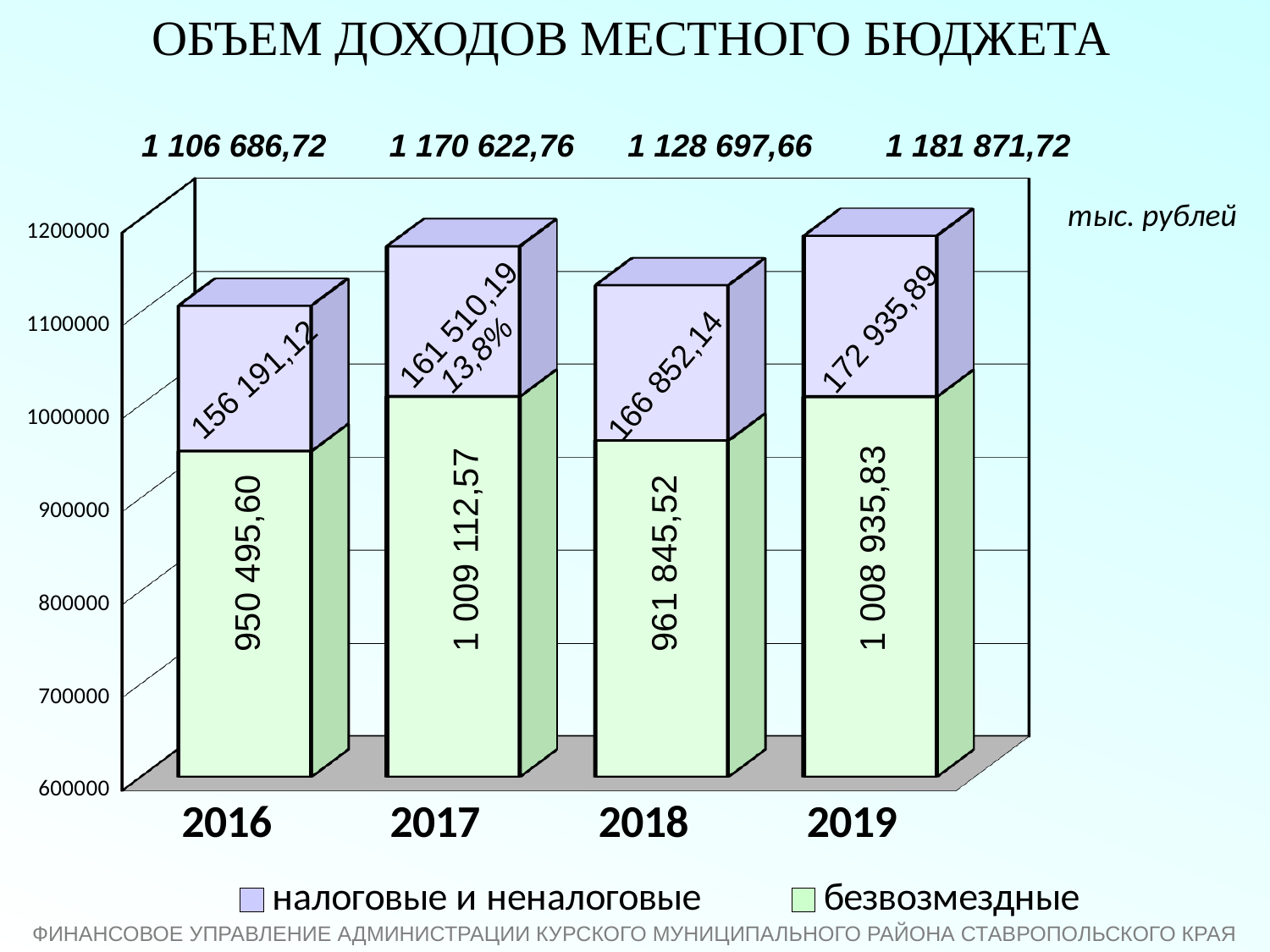
What is the total shown above the bar for 2019? 1 181 871,72 What is the value of налоговые и неналоговые for 2017? 161 510,19 How many series does the legend list? 2 What is the value of безвозмездные for 2018? 961 845,52 Which year has the lowest total income? 2016 What is the total shown above the bar for 2016? 1 106 686,72 How many years are shown on the x axis? 4 What is the value of безвозмездные for 2016? 950 495,60 Do the налоговые и неналоговые values rise or fall from 2016 to 2019? rise Which year has the highest value for налоговые и неналоговые? 2019 Which year has the larger безвозмездные value, 2017 or 2018? 2017 What is the difference between the налоговые и неналоговые values for 2019 and 2016? 16 744,77